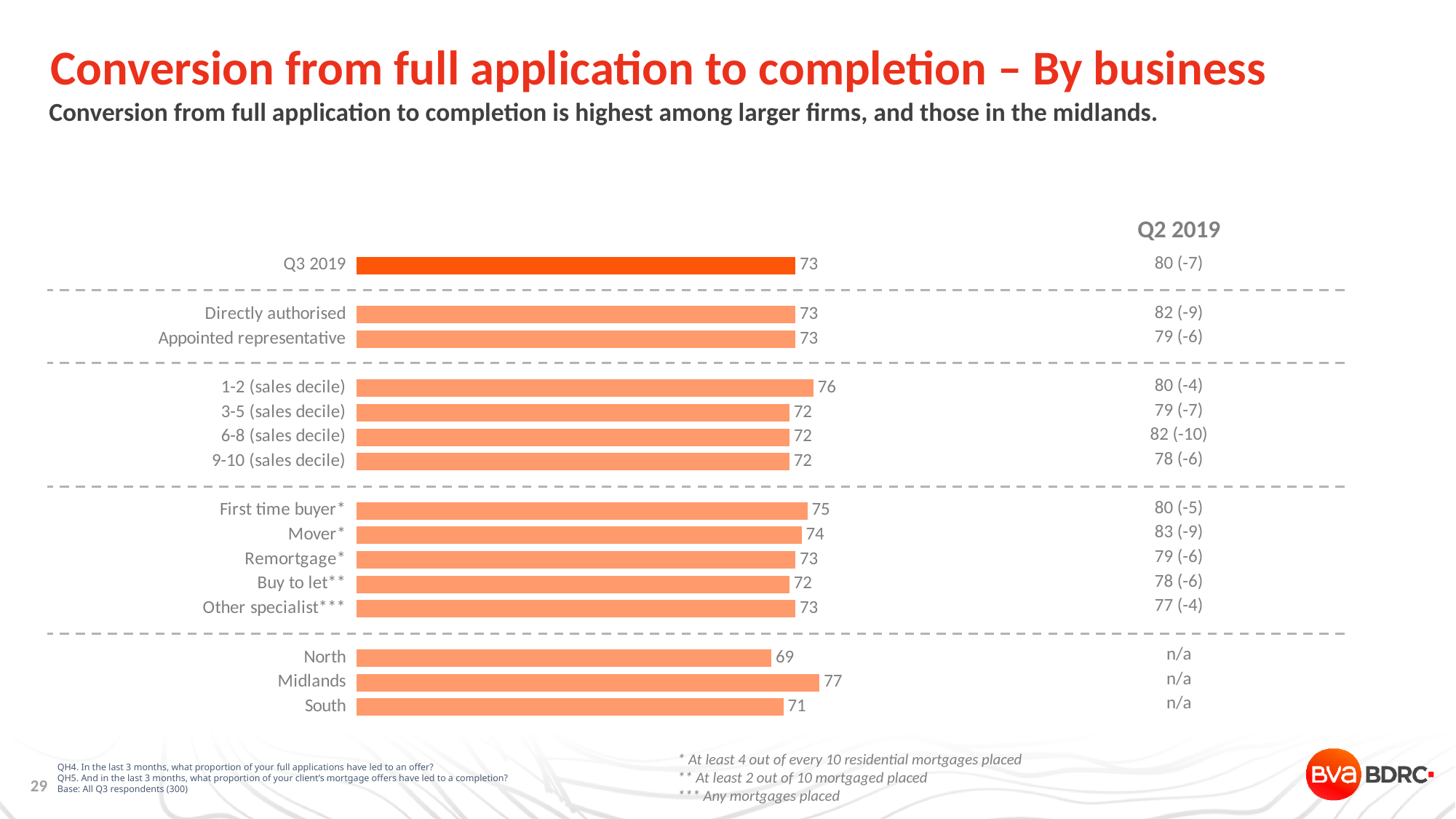
Which category has the lowest value on the chart? North What is the value for Q3 2019 overall? 73 Which is larger, the value for 1-2 (sales decile) or 9-10 (sales decile)? 1-2 (sales decile) What Q2 2019 value is shown for Mover? 83 (-9) What is the difference between the values for First time buyer and Buy to let? 3 What is the value for First time buyer? 75 How many bars are plotted on the chart? 15 What kind of chart is shown on the slide? Bar chart Which category has the highest value on the chart? Midlands What is the difference between the values for Midlands and North? 8 What is the value for Midlands? 77 What is the value for North? 69